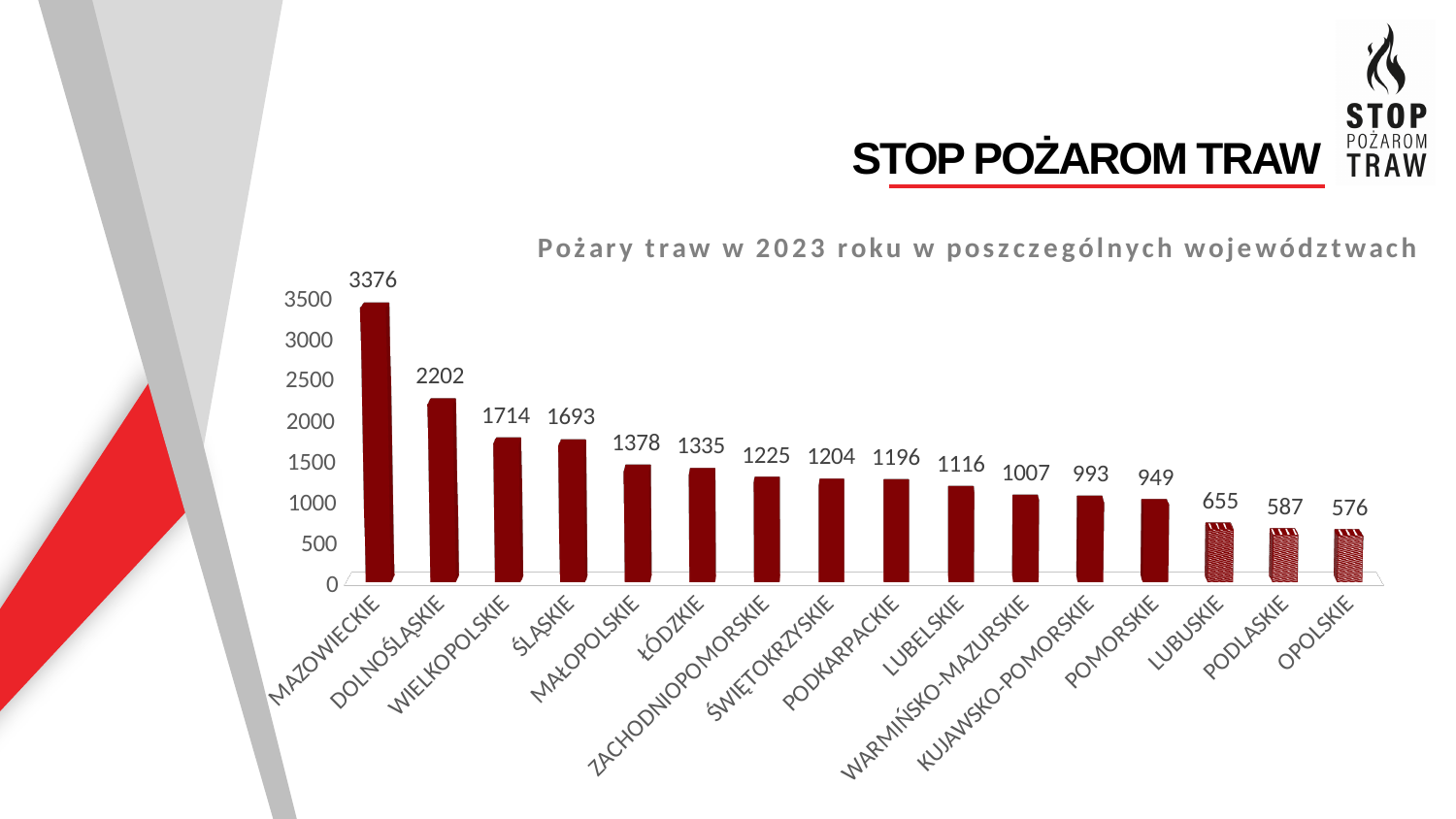
Is the value for WIELKOPOLSKIE greater or less than 1500? greater What is the value for POMORSKIE? 949 Which voivodeship has the highest value? MAZOWIECKIE What is the title of the chart? Pożary traw w 2023 roku w poszczególnych województwach Which is larger, the value for LUBELSKIE or the value for WARMIŃSKO-MAZURSKIE? LUBELSKIE Do the values rise or fall from left to right along the x axis? fall What kind of chart is shown on the slide? bar chart What is the value for ŚLĄSKIE? 1693 What is the value for MAZOWIECKIE? 3376 What is the difference between the values for MAZOWIECKIE and DOLNOŚLĄSKIE? 1174 Which voivodeship has the lowest value? OPOLSKIE How many voivodeships are shown on the chart? 16